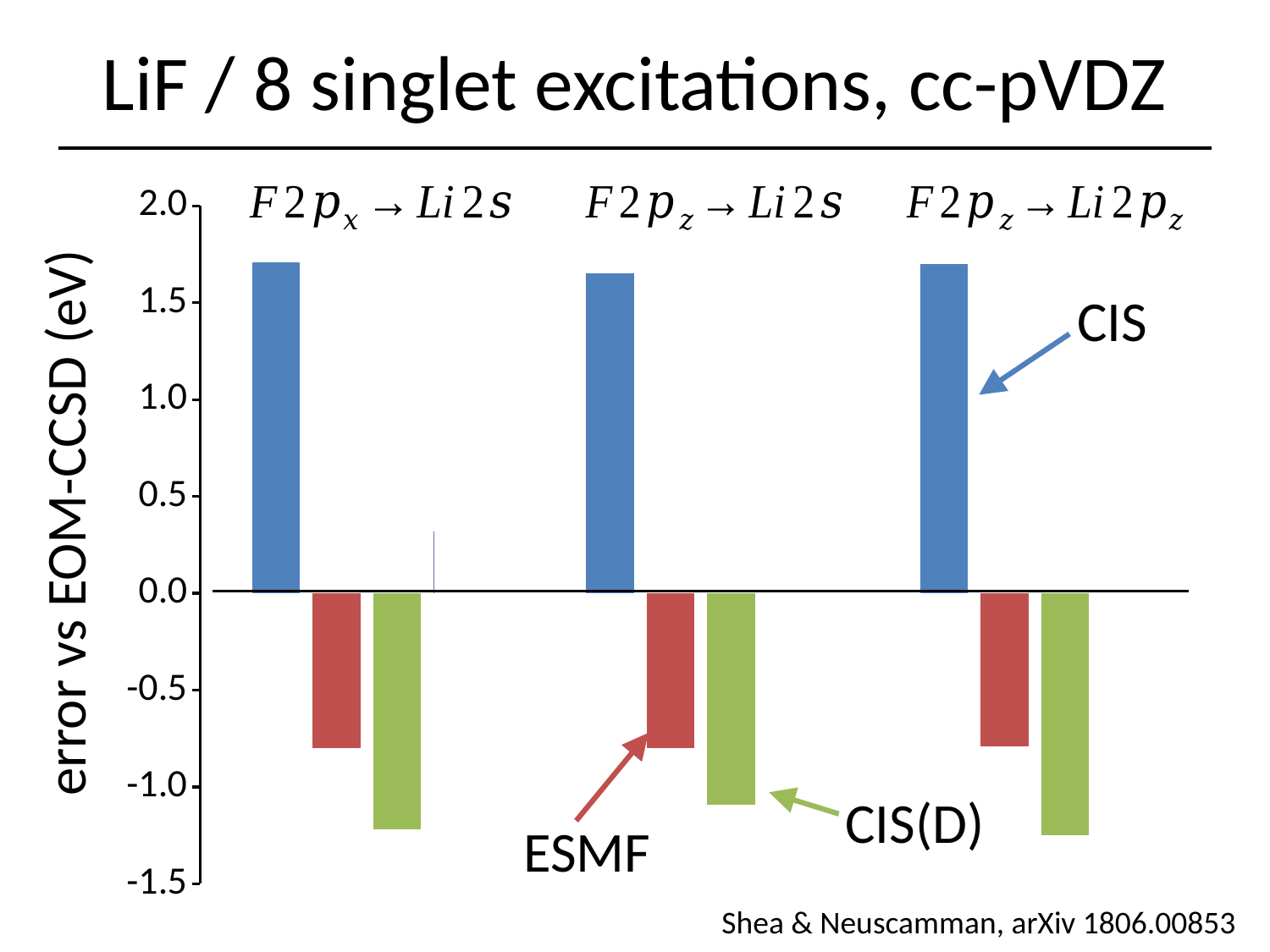
What is the label of the y axis? error vs EOM-CCSD (eV) What is the title of the slide's chart? LiF / 8 singlet excitations, cc-pVDZ For the F 2px → Li 2s excitation, which method has the lowest (most negative) error value? CIS(D) What kind of chart is shown on the slide? bar chart How many excitation categories are shown along the x axis? 3 Is the CIS error for the F 2px → Li 2s excitation greater or less than 1.5? greater For the F 2pz → Li 2pz excitation, which is larger: the CIS error or the ESMF error? CIS Is the CIS(D) error for the F 2pz → Li 2pz excitation greater or less than -1.0? less For the F 2pz → Li 2s excitation, which method has the highest error value? CIS How many methods (series) are labelled on the chart? 3 Is the CIS error for the F 2pz → Li 2s excitation greater or less than 1.0? greater